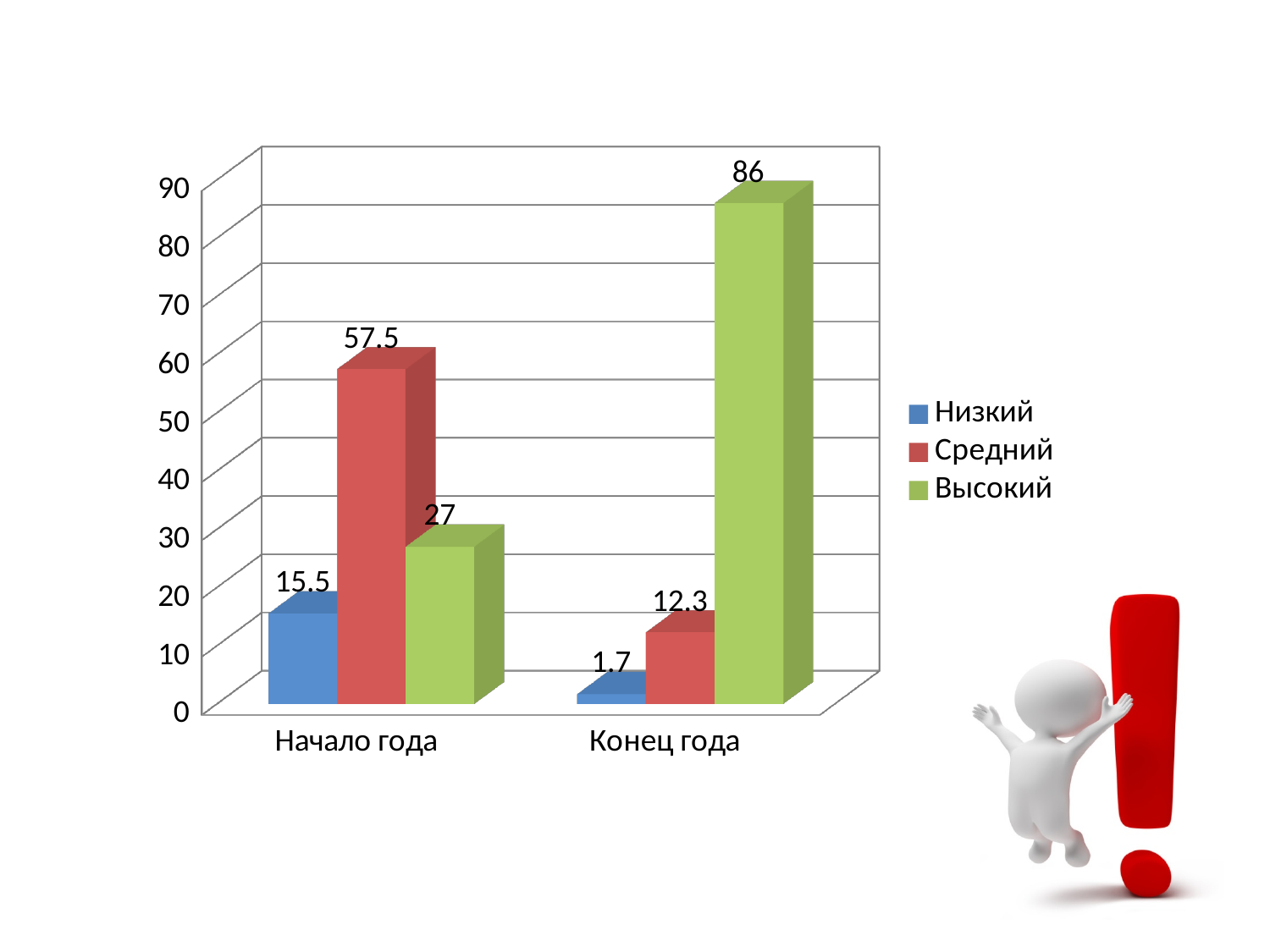
What kind of chart is shown on the slide? Bar chart How many categories are shown on the x axis? 2 What is the value for Средний at Начало года? 57.5 Which is larger: Средний at Начало года or Средний at Конец года? Средний at Начало года What is the value for Высокий at Конец года? 86 What is the difference between the Высокий values at Конец года and Начало года? 59 How many series does the legend list? 3 Which series has the highest value at Конец года? Высокий What is the value for Низкий at Начало года? 15.5 Which series has the lowest value at Начало года? Низкий What is the value for Низкий at Конец года? 1.7 Does the Высокий series rise or fall from Начало года to Конец года? Rise